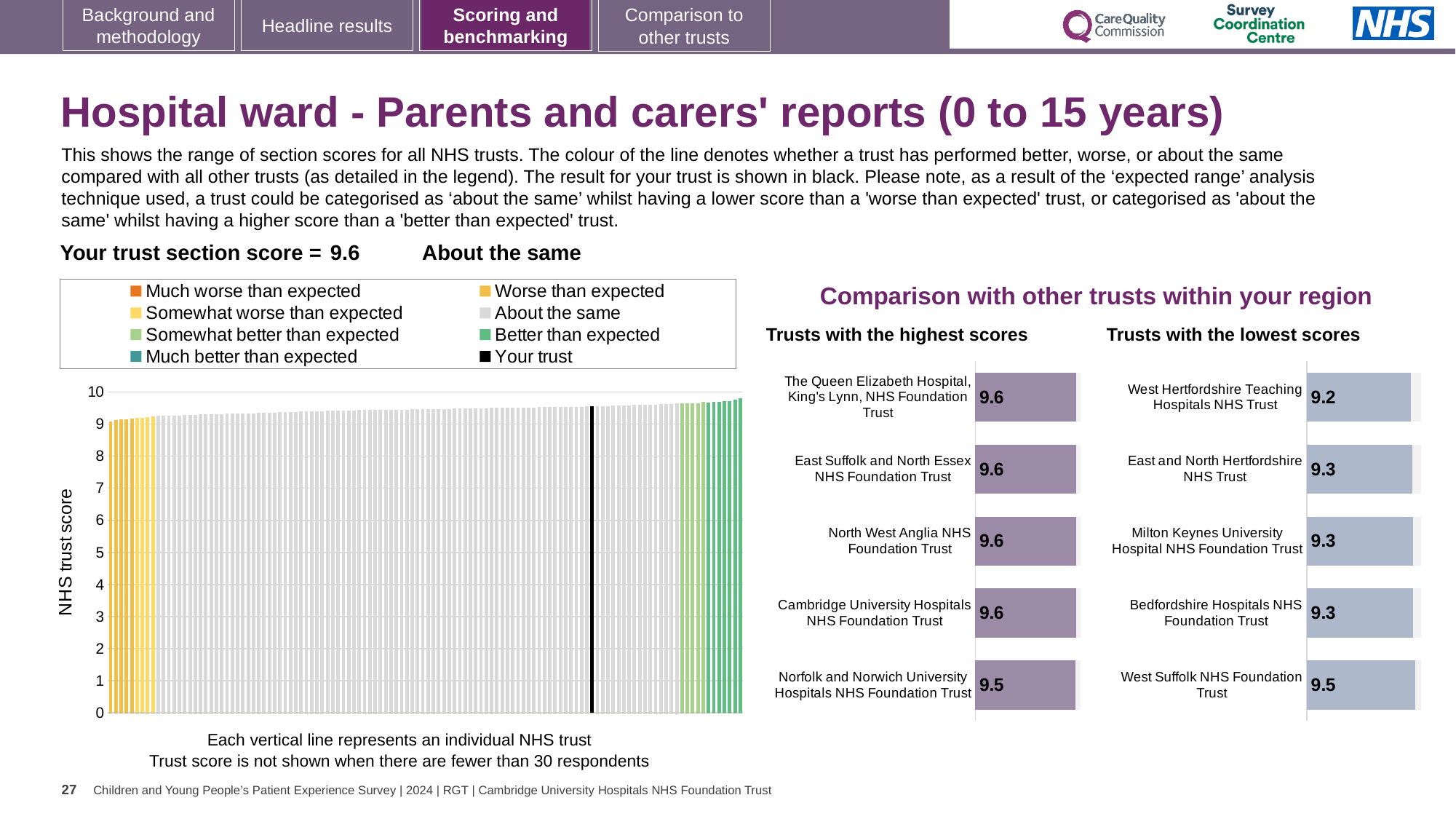
Which has the higher score: Cambridge University Hospitals NHS Foundation Trust in the 'highest scores' chart or West Hertfordshire Teaching Hospitals NHS Trust in the 'lowest scores' chart? Cambridge University Hospitals NHS Foundation Trust What is the y-axis label of the main chart on the left? NHS trust score How many trusts are listed in the 'Trusts with the lowest scores' chart? 5 In the 'Trusts with the highest scores' chart, what is the difference between the scores of East Suffolk and North Essex NHS Foundation Trust and Norfolk and Norwich University Hospitals NHS Foundation Trust? 0.1 In the 'Trusts with the highest scores' chart, which trust has the lowest score? Norfolk and Norwich University Hospitals NHS Foundation Trust In the 'Trusts with the lowest scores' chart, which trust has the lowest score? West Hertfordshire Teaching Hospitals NHS Trust In the main chart on the left, is the value for the black 'Your trust' line greater or less than 9? greater In the 'Trusts with the highest scores' chart, what is the score for The Queen Elizabeth Hospital, King's Lynn, NHS Foundation Trust? 9.6 In the 'Trusts with the lowest scores' chart, what is the score for West Hertfordshire Teaching Hospitals NHS Trust? 9.2 In the 'Trusts with the lowest scores' chart, what is the difference between the scores of West Suffolk NHS Foundation Trust and West Hertfordshire Teaching Hospitals NHS Trust? 0.3 In the 'Trusts with the lowest scores' chart, which trust has the highest score? West Suffolk NHS Foundation Trust In the 'Trusts with the highest scores' chart, what is the score for Norfolk and Norwich University Hospitals NHS Foundation Trust? 9.5